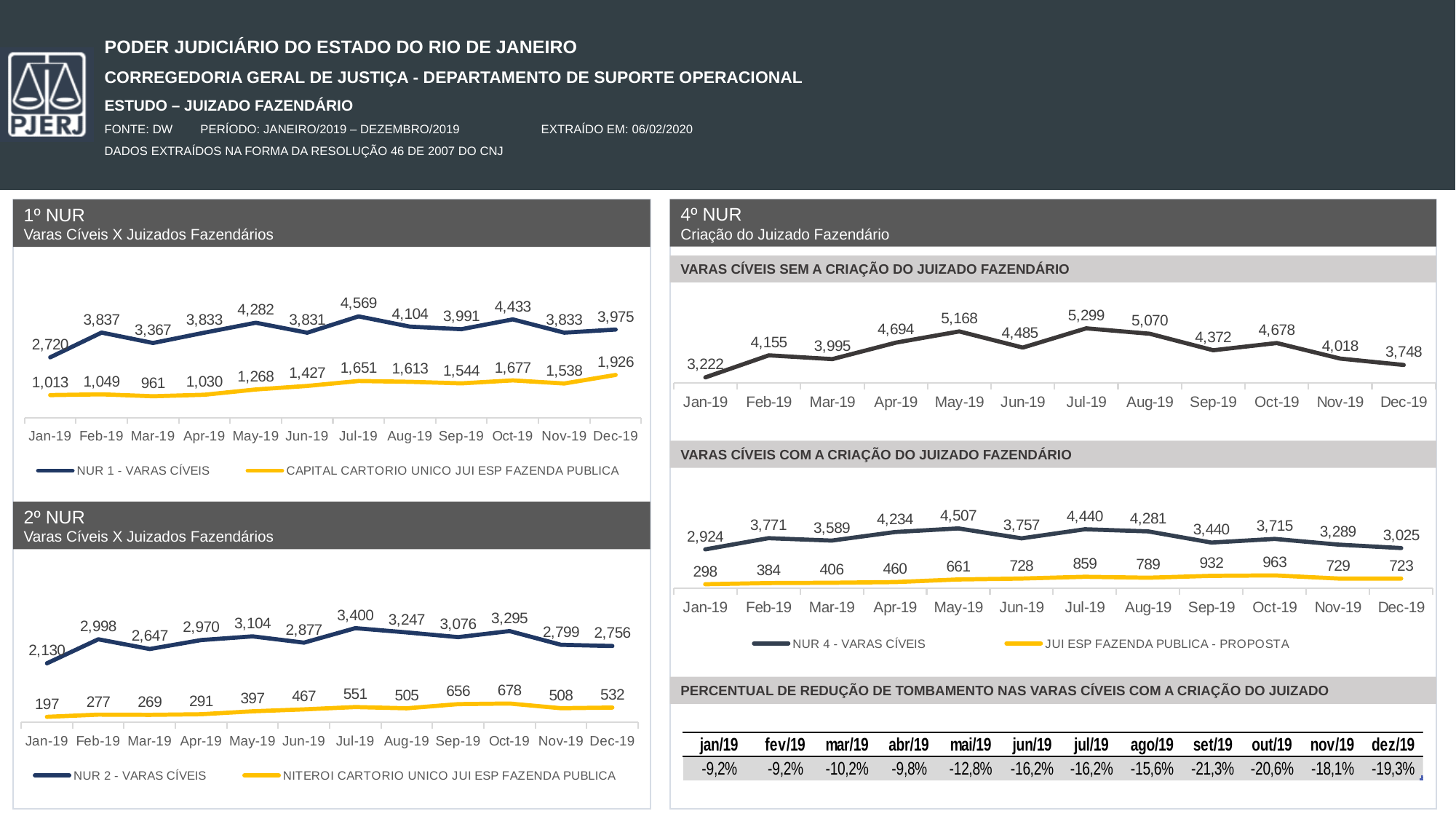
In the 1º NUR chart, what is the value for NUR 1 - VARAS CÍVEIS in Jul-19? 4,569 In the 1º NUR chart, what is the difference between NUR 1 - VARAS CÍVEIS and CAPITAL CARTORIO UNICO JUI ESP FAZENDA PUBLICA in Dec-19? 2,049 In the 2º NUR chart, in which month is NUR 2 - VARAS CÍVEIS lowest? Jan-19 In the 4º NUR chart 'Varas Cíveis sem a criação do Juizado Fazendário', which month has the highest value? Jul-19 In the 4º NUR chart 'Varas Cíveis sem a criação do Juizado Fazendário', what is the value for Dec-19? 3,748 In the 1º NUR chart, in which month is the CAPITAL CARTORIO UNICO JUI ESP FAZENDA PUBLICA series highest? Dec-19 In the 4º NUR chart 'Varas Cíveis com a criação do Juizado Fazendário', is the NUR 4 - VARAS CÍVEIS value larger in Apr-19 or Jun-19? Apr-19 How many months are plotted on the x axis of the 2º NUR chart? 12 What kind of chart is the 4º NUR 'Varas Cíveis com a criação do Juizado Fazendário' chart? Line chart In the 2º NUR chart, what is the value for NITEROI CARTORIO UNICO JUI ESP FAZENDA PUBLICA in Oct-19? 678 In the 4º NUR chart 'Varas Cíveis sem a criação do Juizado Fazendário', do the values rise or fall from Oct-19 to Dec-19? Fall How many series does the legend of the 2º NUR chart list? 2